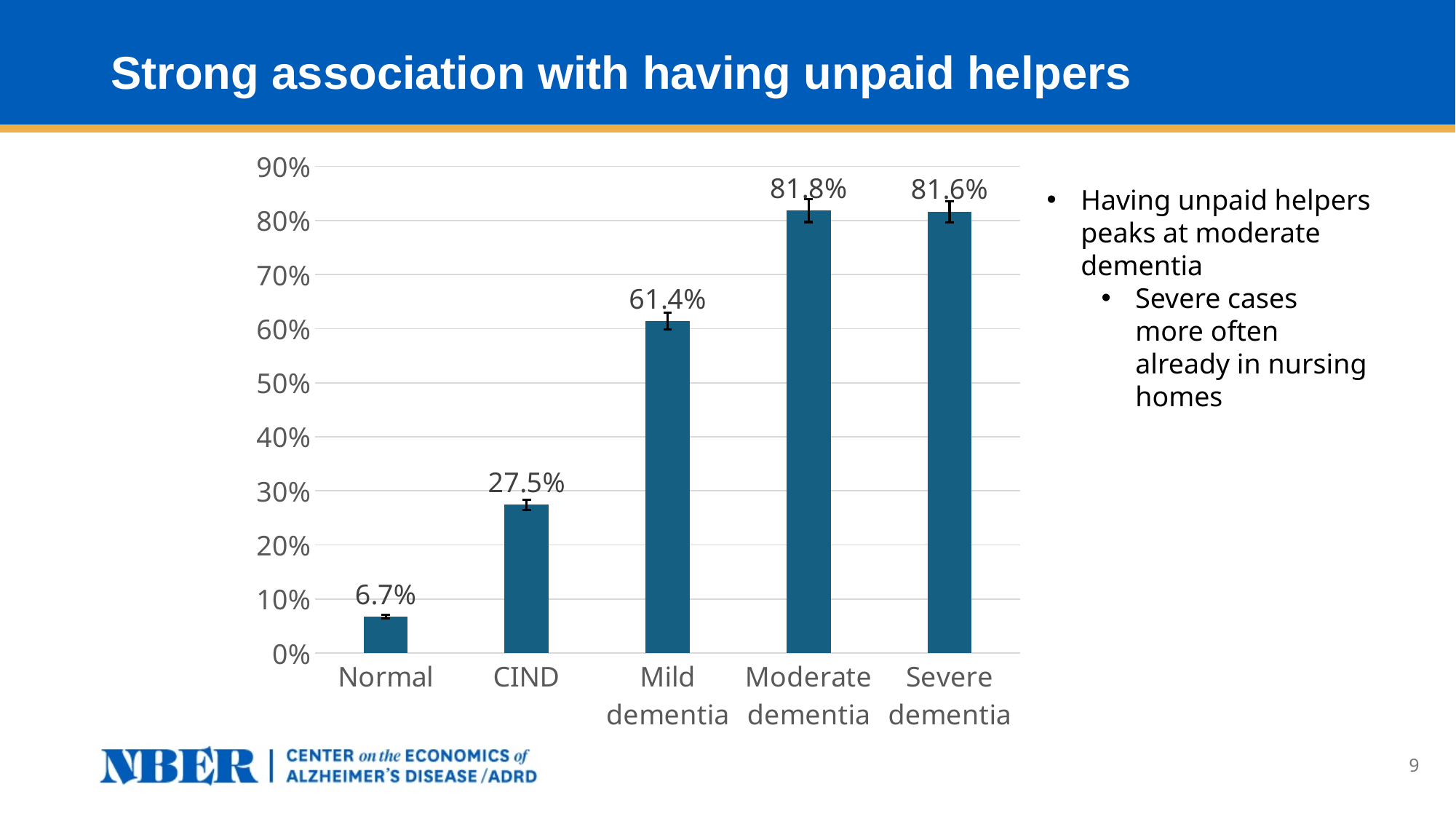
Which category has the lowest value? Normal What kind of chart is shown on the slide? Bar chart What is the value for Normal? 6.7% What is the value for Severe dementia? 81.6% What is the value for Moderate dementia? 81.8% Do the values rise or fall from Normal to Moderate dementia? Rise Which is larger, the value for Mild dementia or the value for CIND? Mild dementia What is the difference between the values for Moderate dementia and Severe dementia? 0.2% What is the difference between the values for Mild dementia and CIND? 33.9% What is the value for CIND? 27.5% How many categories are shown on the x axis? 5 What is the value for Mild dementia? 61.4%